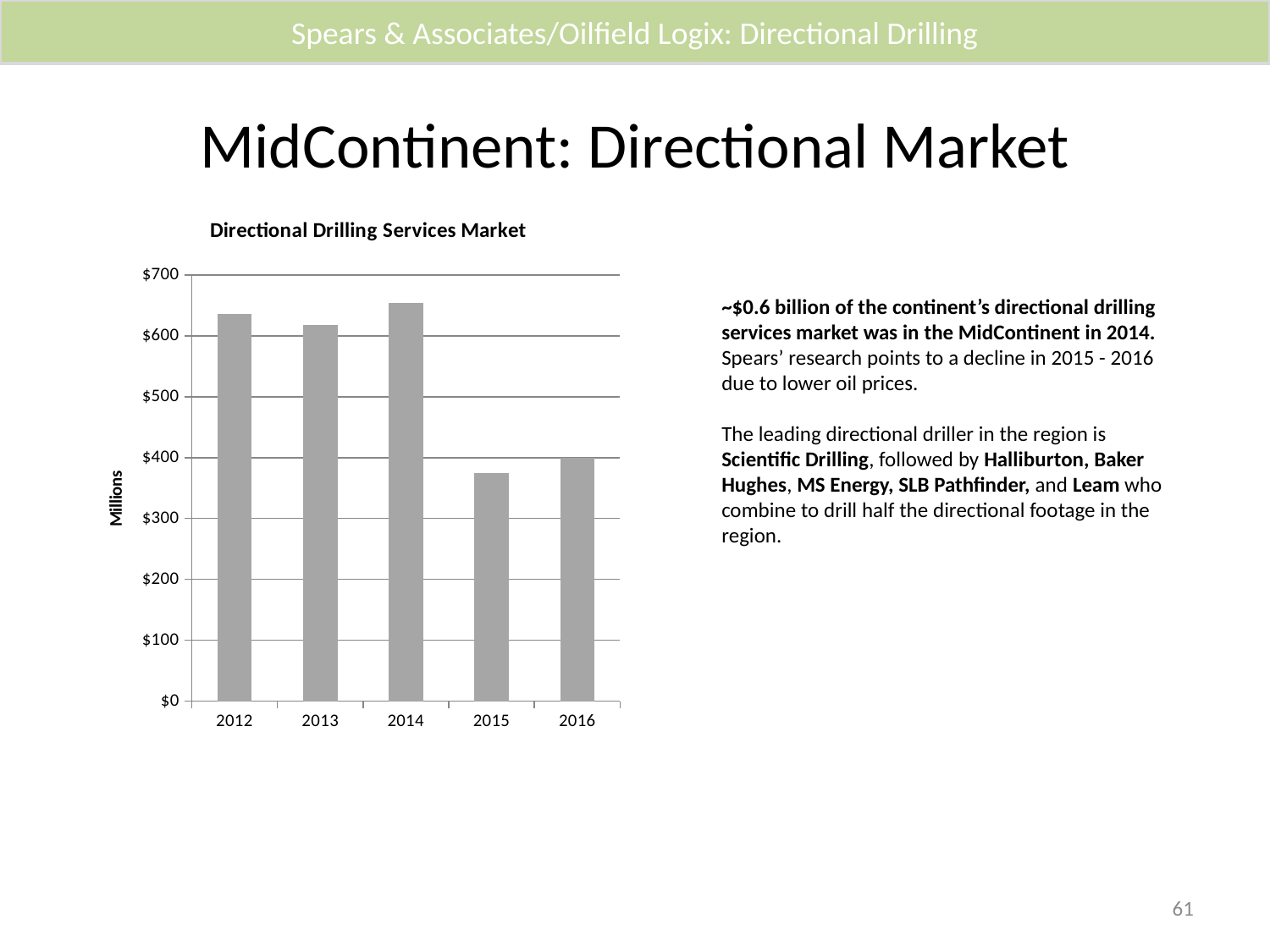
What is the title of the chart? Directional Drilling Services Market Is the value for 2014 greater or less than $600? greater Is the value for 2016 greater or less than $500? less Which year has the highest value in the chart? 2014 Which is larger, the value for 2014 or the value for 2015? 2014 Is the value for 2015 greater or less than $400? less Which year has the lowest value in the chart? 2015 How many years are plotted on the x axis of the chart? 5 What is the label on the vertical axis of the chart? Millions What kind of chart is shown on the slide? bar chart Does the value rise or fall from 2014 to 2015? fall